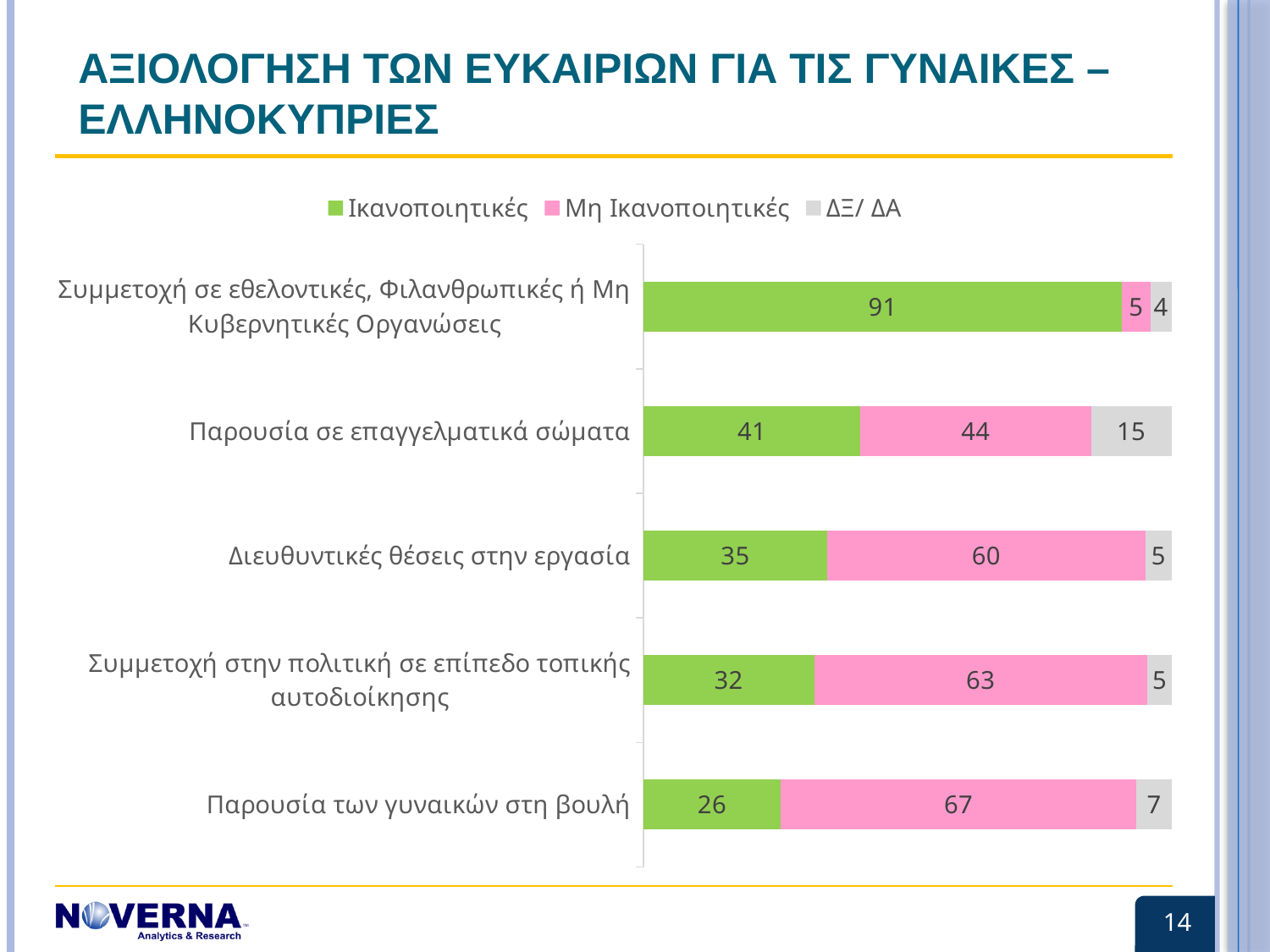
What is the Ικανοποιητικές value for Παρουσία σε επαγγελματικά σώματα? 41 What is the total of the stacked bar for Παρουσία σε επαγγελματικά σώματα? 100 Which is larger for Διευθυντικές θέσεις στην εργασία: the Ικανοποιητικές value or the Μη Ικανοποιητικές value? Μη Ικανοποιητικές Which category has the highest ΔΞ/ ΔΑ value? Παρουσία σε επαγγελματικά σώματα How many series does the legend list? 3 Which category has the lowest Ικανοποιητικές value? Παρουσία των γυναικών στη βουλή How many categories are shown in the chart? 5 What is the Μη Ικανοποιητικές value for Παρουσία των γυναικών στη βουλή? 67 Which category has the highest Ικανοποιητικές value? Συμμετοχή σε εθελοντικές, Φιλανθρωπικές ή Μη Κυβερνητικές Οργανώσεις What is the ΔΞ/ ΔΑ value for Συμμετοχή σε εθελοντικές, Φιλανθρωπικές ή Μη Κυβερνητικές Οργανώσεις? 4 What kind of chart is shown on the slide? Stacked bar chart What is the difference between the Μη Ικανοποιητικές values for Συμμετοχή στην πολιτική σε επίπεδο τοπικής αυτοδιοίκησης and Διευθυντικές θέσεις στην εργασία? 3